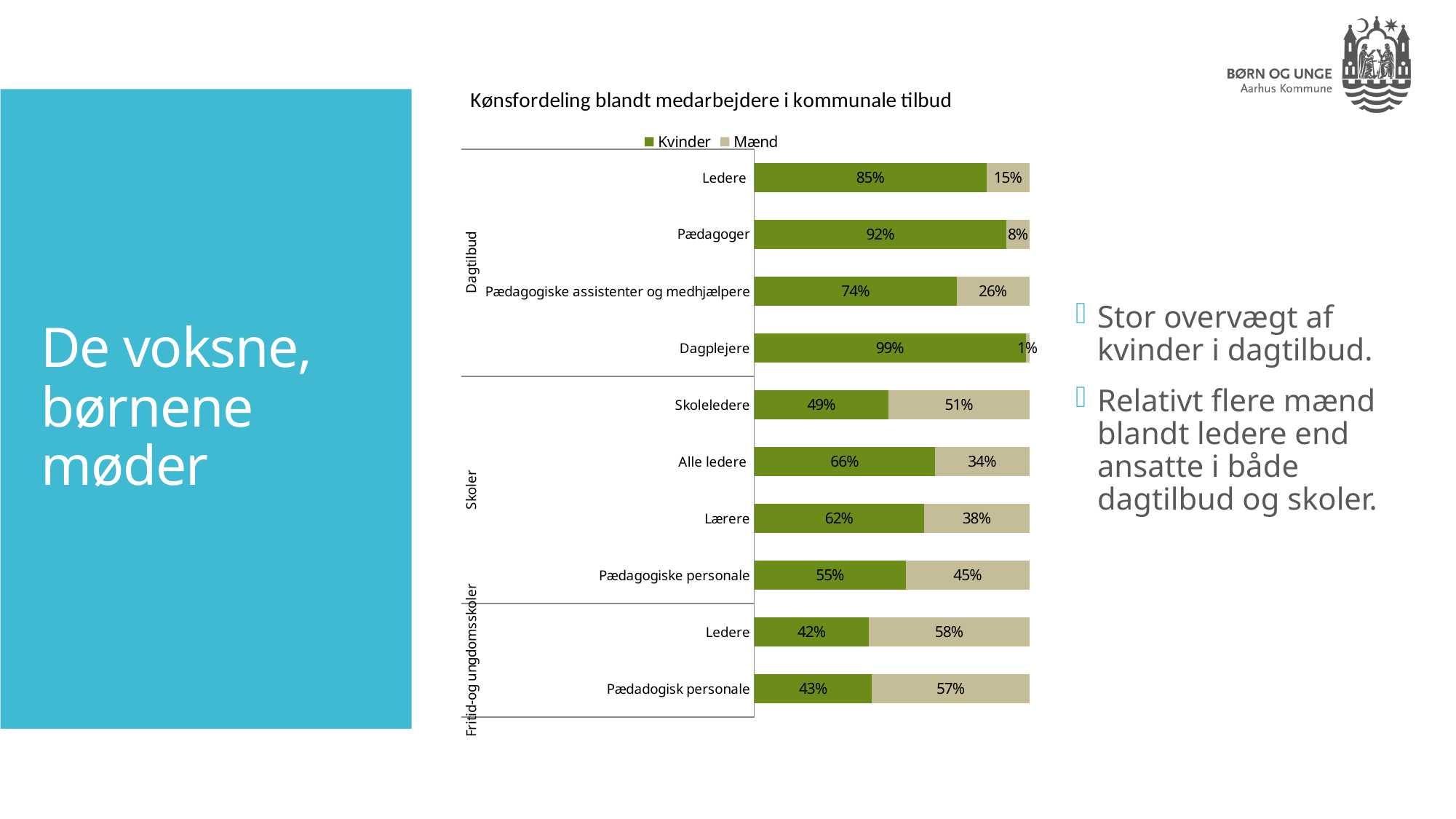
What is the Mænd share for Ledere in the Fritid-og ungdomsskoler group? 58% What is the Kvinder share for Dagplejere? 99% What is the Kvinder share for Skoleledere? 49% What is the difference between the Kvinder share for Pædagoger and the Kvinder share for Lærere? 30 percentage points How many series does the legend list? 2 How many categories are plotted in the chart? 10 What kind of chart is shown on the slide? Stacked bar chart Which is larger: the Mænd share for Lærere or the Mænd share for Alle ledere? Lærere What is the Mænd share for Pædagogiske assistenter og medhjælpere in the Dagtilbud group? 26% Which category has the lowest Kvinder share? Ledere (Fritid-og ungdomsskoler) Which category has the highest Kvinder share? Dagplejere What is the title of the chart? Kønsfordeling blandt medarbejdere i kommunale tilbud